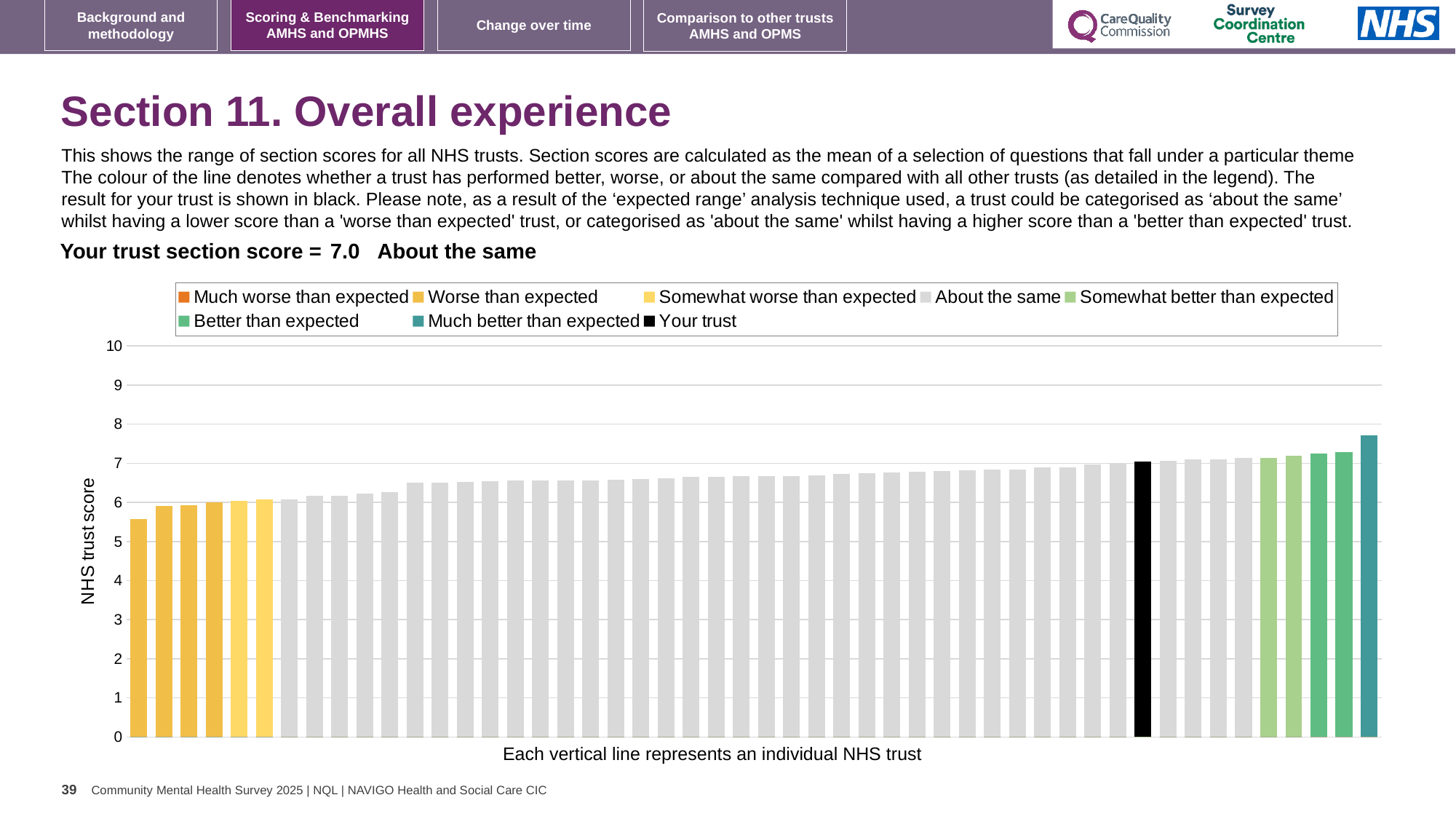
What colour is used for the 'Your trust' bar according to the legend? black Do the bar values rise or fall from left to right along the x axis? rise Is the value of the lowest bar in the chart greater or less than 5? greater What is the label on the vertical axis of the chart? NHS trust score How many bars are coloured as 'Much better than expected'? 1 What kind of chart is shown on the slide? bar chart What is the section score for your trust shown on the slide? 7.0 Is the value of the black 'Your trust' bar greater or less than 6? greater Is the value of the highest bar in the chart greater or less than 8? less How many entries does the chart legend list? 8 Which category is your trust placed in for this section? About the same Which legend category does the tallest bar belong to? Much better than expected